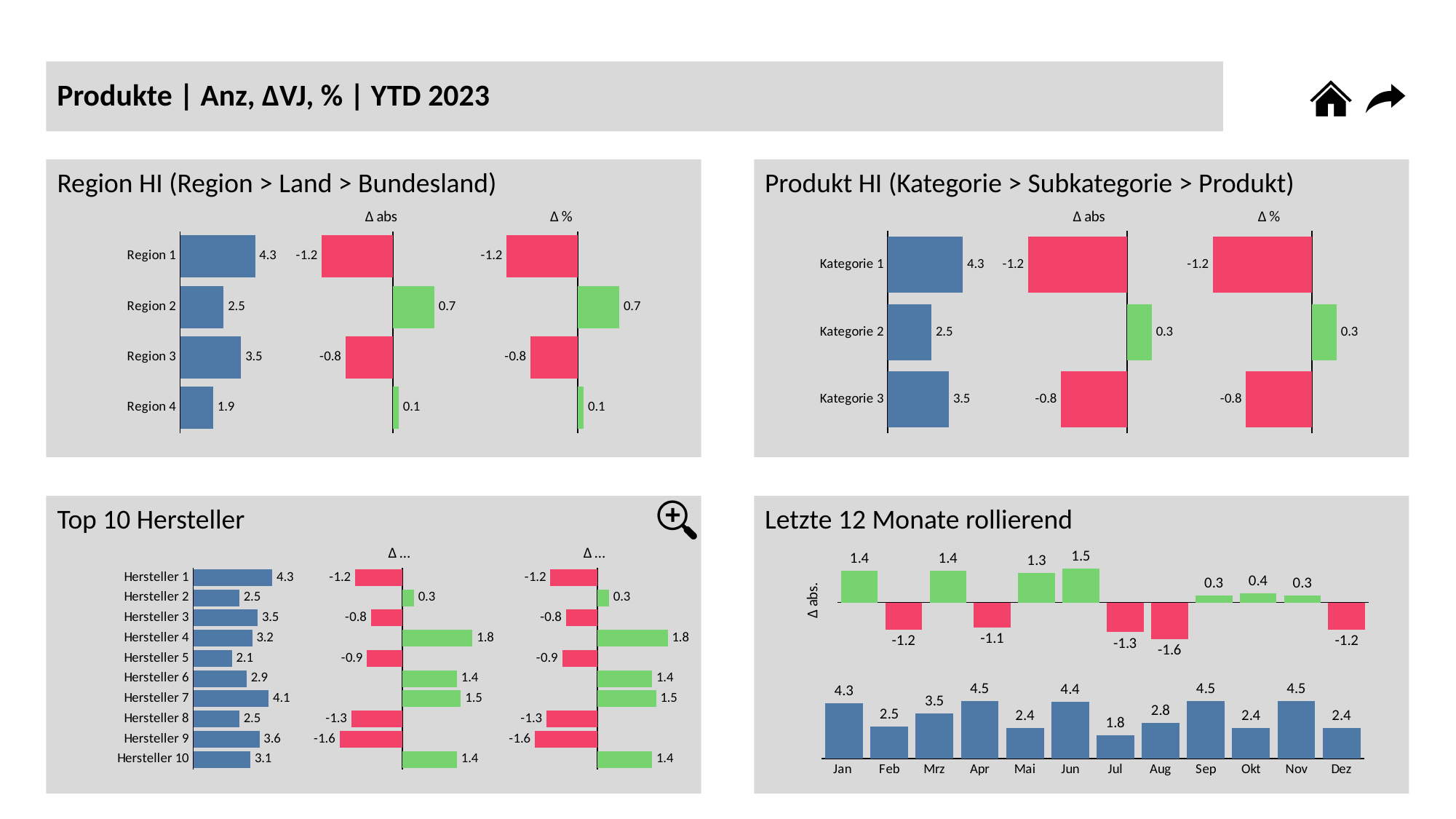
In the 'Top 10 Hersteller' chart, what is the value for Hersteller 7? 4.1 In the 'Letzte 12 Monate rollierend' chart, what is the Δ abs. value for Aug? -1.6 What kind of chart is used in the 'Letzte 12 Monate rollierend' panel? Bar chart In the 'Region HI' chart, what is the value for Region 3? 3.5 In the 'Produkt HI' chart, how many categories are shown? 3 In the 'Top 10 Hersteller' chart, what is the difference between the values for Hersteller 1 and Hersteller 9? 0.7 In the 'Region HI' chart, what is the Δ abs value for Region 2? 0.7 In the 'Region HI' chart, which region has the lowest value? Region 4 In the 'Letzte 12 Monate rollierend' chart, is the bottom bar value for Jan larger or the value for Jun? Jun In the 'Produkt HI' chart, what is the Δ % value for Kategorie 3? -0.8 In the 'Letzte 12 Monate rollierend' chart, which month has the lowest value in the bottom bar chart? Jul In the 'Top 10 Hersteller' chart, which Hersteller has the lowest value? Hersteller 5